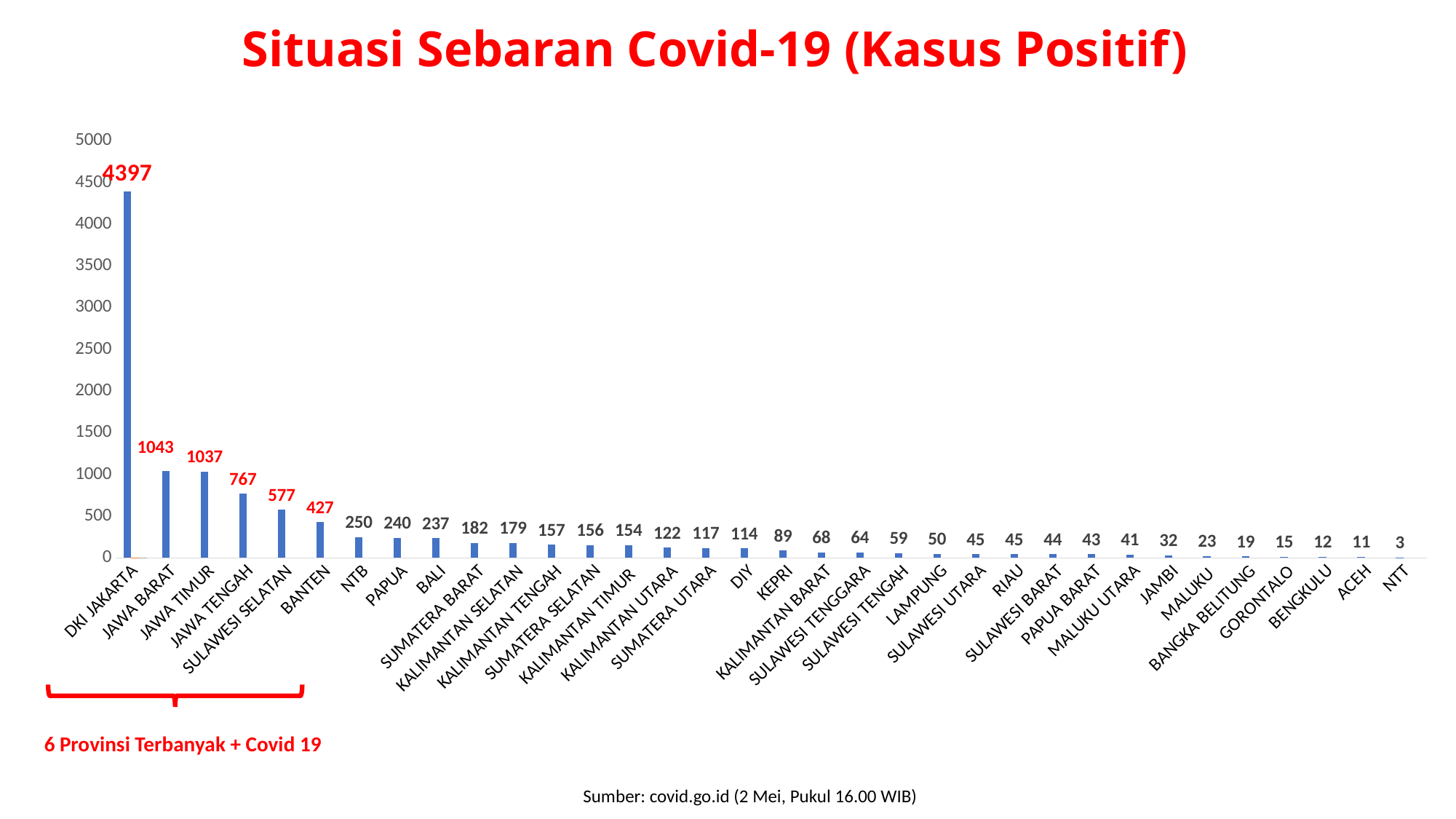
Which province has the lowest number of positive cases? NTT What is the number of positive cases for DKI JAKARTA? 4397 Which has a larger value, SULAWESI SELATAN or BANTEN? SULAWESI SELATAN What is the difference between the values for JAWA BARAT and JAWA TIMUR? 6 How many provinces are shown on the chart? 34 What is the value shown for JAWA TENGAH? 767 What kind of chart is shown on the slide? Bar chart What is the value shown for KALIMANTAN SELATAN? 179 Is the value for JAWA BARAT greater or less than 1000? greater What is the title of the chart? Situasi Sebaran Covid-19 (Kasus Positif) What is the difference between the values for DKI JAKARTA and BANTEN? 3970 Which province has the highest number of positive cases? DKI JAKARTA